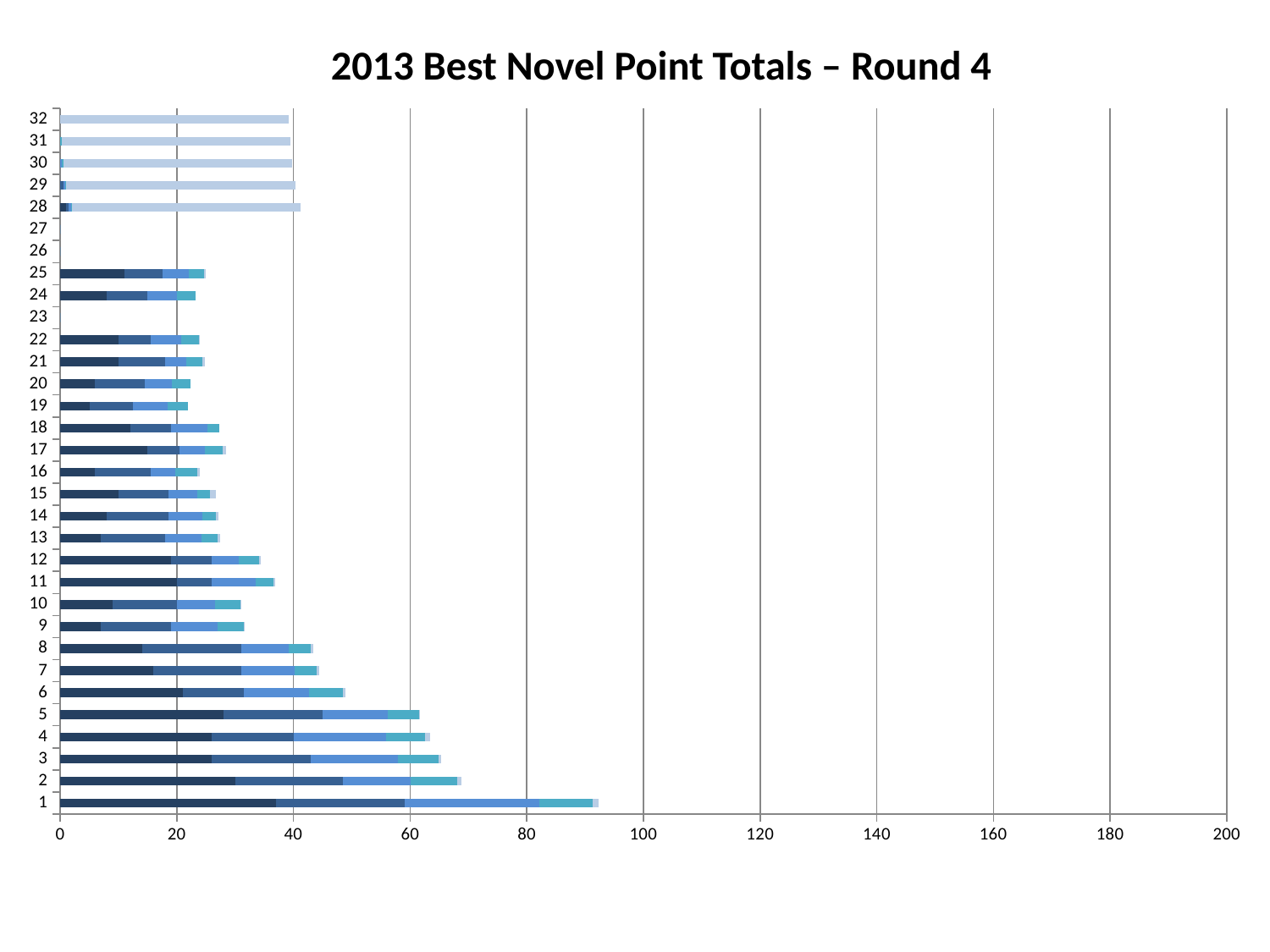
How many categories are listed on the vertical axis of the chart? 32 Is the total value for category 2 greater or less than 80? less Is the total value for category 25 greater or less than 20? greater Which category has the longest bar in the chart? 1 What is the highest value shown on the horizontal axis? 200 Is the total value for category 6 greater or less than 40? greater What is the title of the chart? 2013 Best Novel Point Totals – Round 4 What kind of chart is shown on the slide? Stacked bar chart Which has the larger total, category 1 or category 2? 1 Which has the larger total, category 6 or category 8? 6